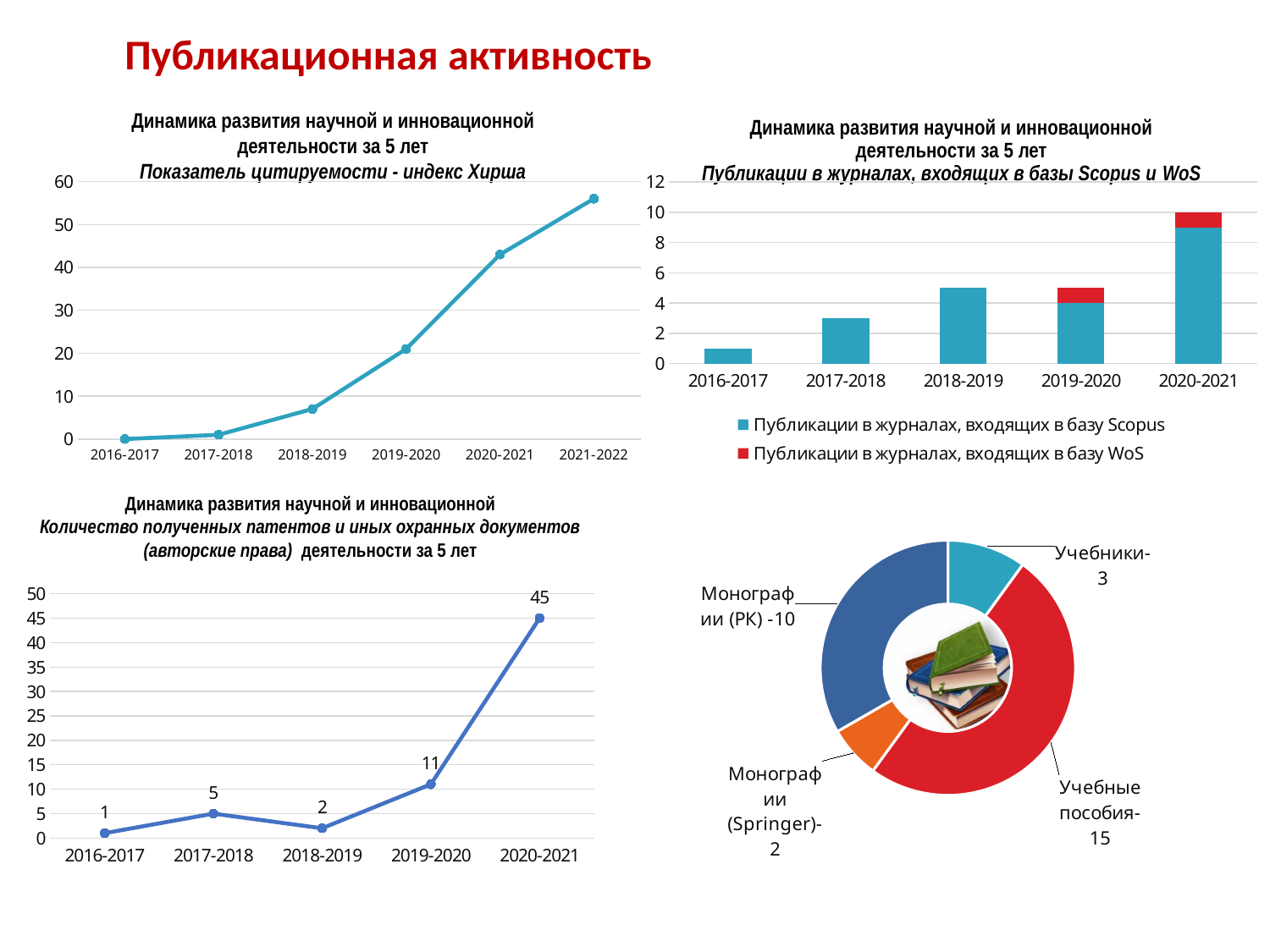
On the bottom-left chart (Количество полученных патентов и иных охранных документов), what is the value for 2019-2020? 11 On the bottom-left chart (Количество полученных патентов и иных охранных документов), what is the value for 2020-2021? 45 On the top-left chart (Показатель цитируемости - индекс Хирша), is the value for 2018-2019 greater or less than 10? less On the top-right chart (Публикации в журналах, входящих в базы Scopus и WoS), how many series does the legend list? 2 On the bottom-right donut chart, what is the value for Учебные пособия? 15 On the bottom-right donut chart, what share of the total do Учебные пособия represent? 50% On the top-right chart (Публикации в журналах, входящих в базы Scopus и WoS), which period has the tallest stacked bar? 2020-2021 On the bottom-left chart (Количество полученных патентов и иных охранных документов), which period has the lowest value? 2016-2017 On the top-left chart (Показатель цитируемости - индекс Хирша), is the value for 2021-2022 greater or less than 50? greater On the bottom-left chart (Количество полученных патентов и иных охранных документов), how many periods are plotted on the x axis? 5 On the top-left chart (Показатель цитируемости - индекс Хирша), do the values rise or fall from 2016-2017 to 2021-2022? rise On the bottom-left chart (Количество полученных патентов и иных охранных документов), what is the difference between the values for 2020-2021 and 2019-2020? 34